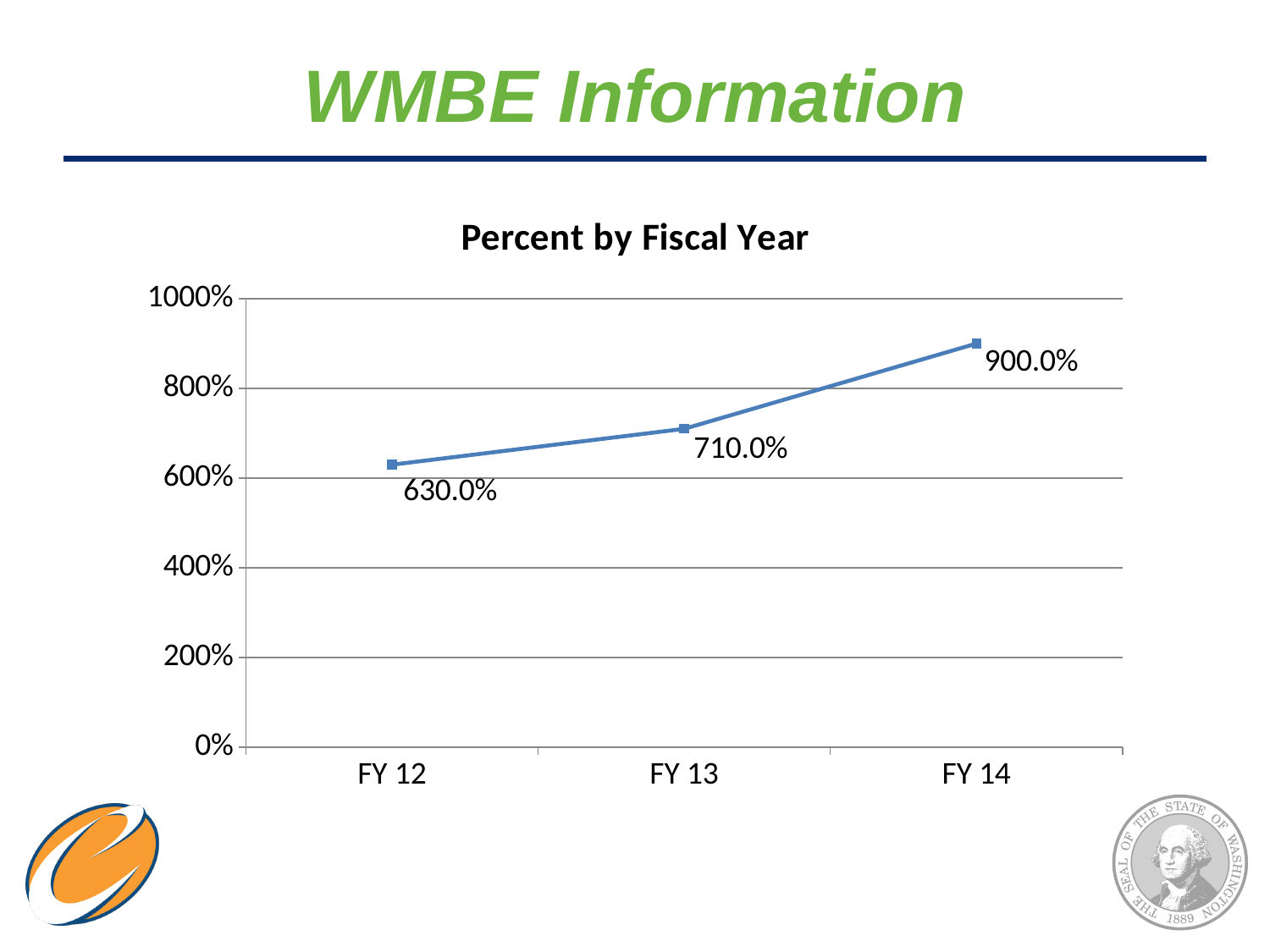
Is the value for FY 13 greater or less than 800%? less What is the difference between the values for FY 14 and FY 13? 190.0% What is the difference between the values for FY 13 and FY 12? 80.0% Which is larger, the value for FY 12 or the value for FY 14? FY 14 Which fiscal year has the highest value? FY 14 What is the value for FY 13? 710.0% What kind of chart is shown on the slide? line chart How many fiscal years are plotted on the chart? 3 Do the values rise or fall from FY 12 to FY 14? rise What is the value for FY 14? 900.0% What is the value for FY 12? 630.0% Which fiscal year has the lowest value? FY 12